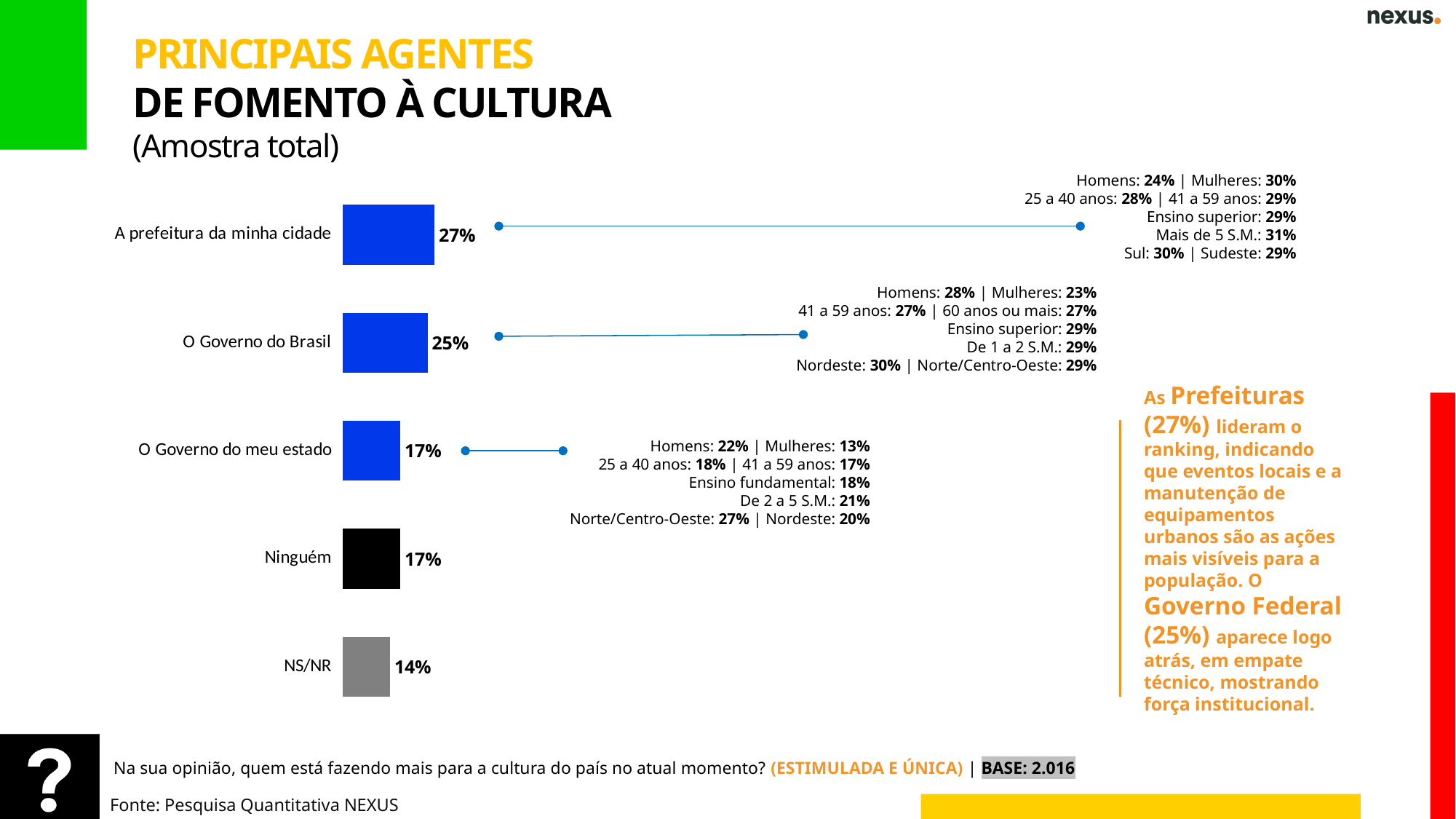
Which category has the lowest value? NS/NR What colour is the bar for "Ninguém"? Black Which is larger, the value for "O Governo do Brasil" or the value for "O Governo do meu estado"? O Governo do Brasil How many categories are shown in the chart? 5 What is the difference between the values for "O Governo do Brasil" and "NS/NR"? 11% What is the value for "Ninguém"? 17% What is the value for "NS/NR"? 14% Which category has the highest value? A prefeitura da minha cidade What is the value for "O Governo do Brasil"? 25% What is the value for "A prefeitura da minha cidade"? 27% What is the difference between the values for "A prefeitura da minha cidade" and "O Governo do Brasil"? 2% What kind of chart is shown on the slide? Bar chart